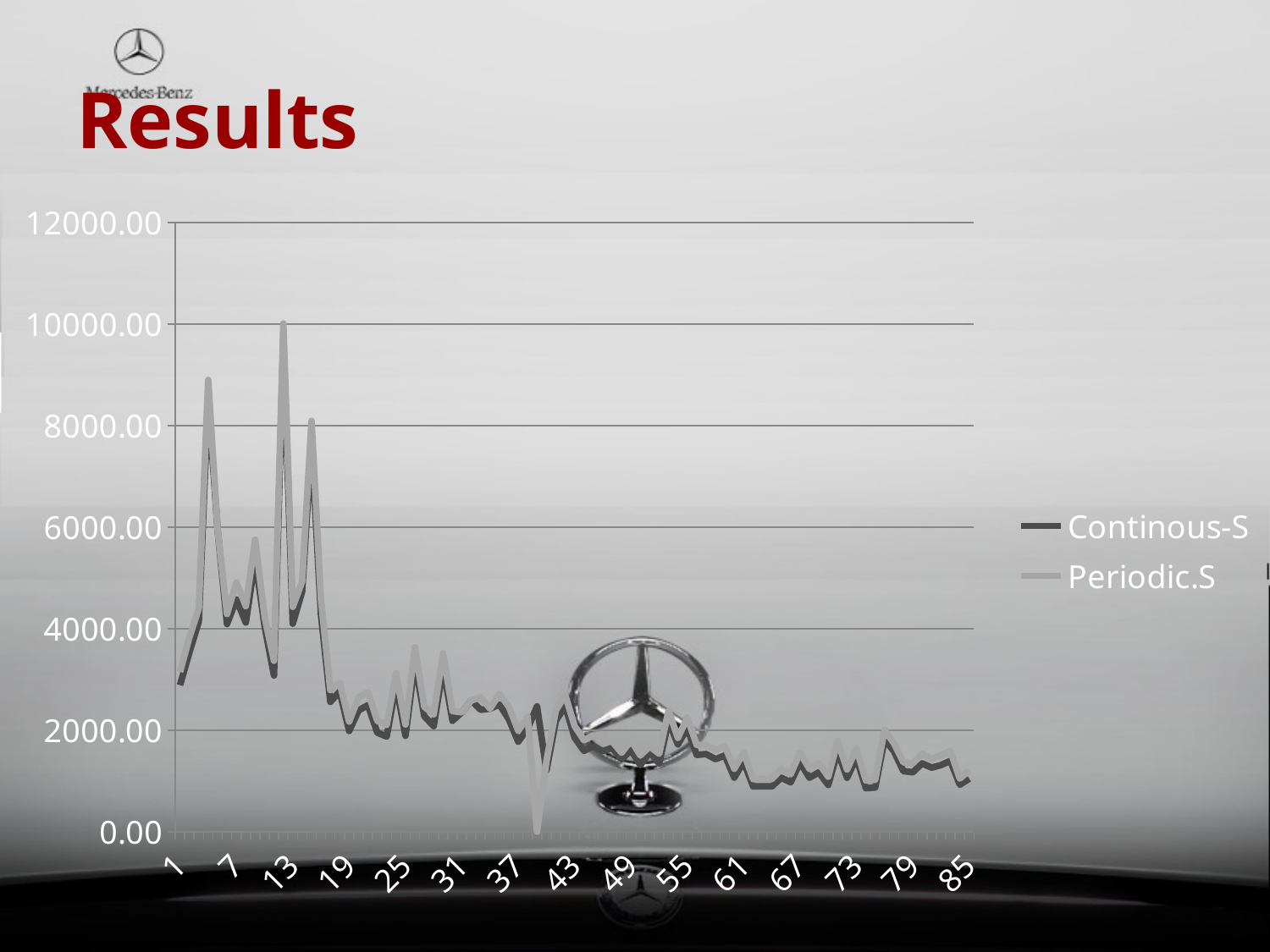
How many series does the legend list? 2 What is the highest value shown on the y axis? 12000.00 What are the names of the two series in the legend? Continous-S and Periodic.S Is the value of Continous-S at x = 7 greater or less than 6000.00? less Is the value of Periodic.S at x = 85 greater or less than 2000.00? less Is the value of Continous-S at x = 1 greater or less than 4000.00? less At x = 7, which series has the higher value, Continous-S or Periodic.S? Periodic.S Overall, do the values of Continous-S rise or fall as x increases from 1 to 85? fall What is the title of the slide containing the chart? Results What kind of chart is shown on the slide? line chart At x = 13, which series has the higher value, Continous-S or Periodic.S? Periodic.S